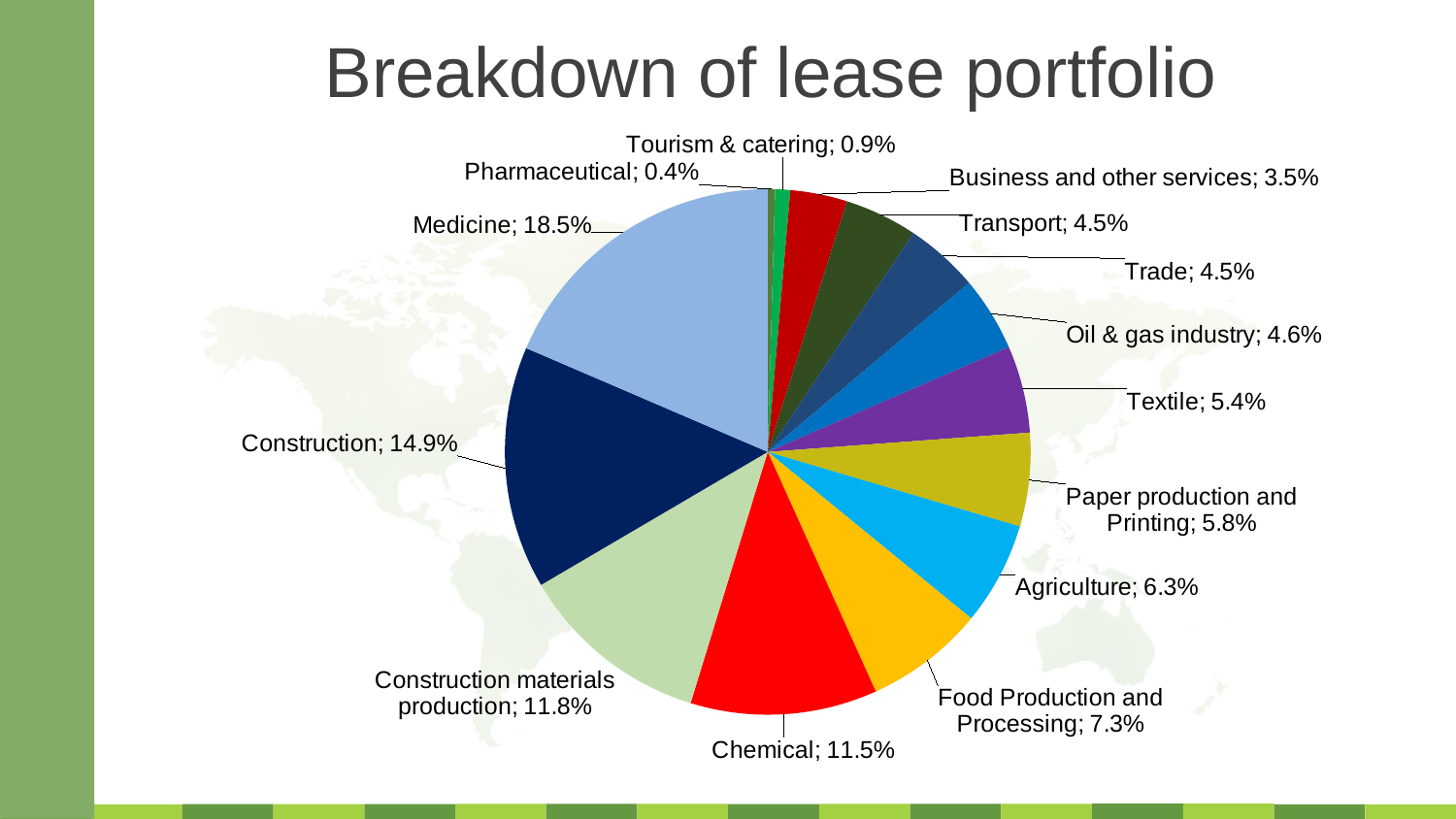
Which category has the largest share of the lease portfolio? Medicine What percentage is shown for Food Production and Processing? 7.3% What is the difference between the shares of Medicine and Construction? 3.6% What share of the lease portfolio does Medicine account for? 18.5% Which is larger, the share for Chemical or the share for Agriculture? Chemical What is the title of the chart? Breakdown of lease portfolio Which category has the smallest share of the lease portfolio? Pharmaceutical What kind of chart is shown on the slide? pie chart How many categories are shown in the pie chart? 14 What is the value for Pharmaceutical? 0.4% What is the value shown for Construction materials production? 11.8% What is the combined share of Transport and Trade? 9.0%